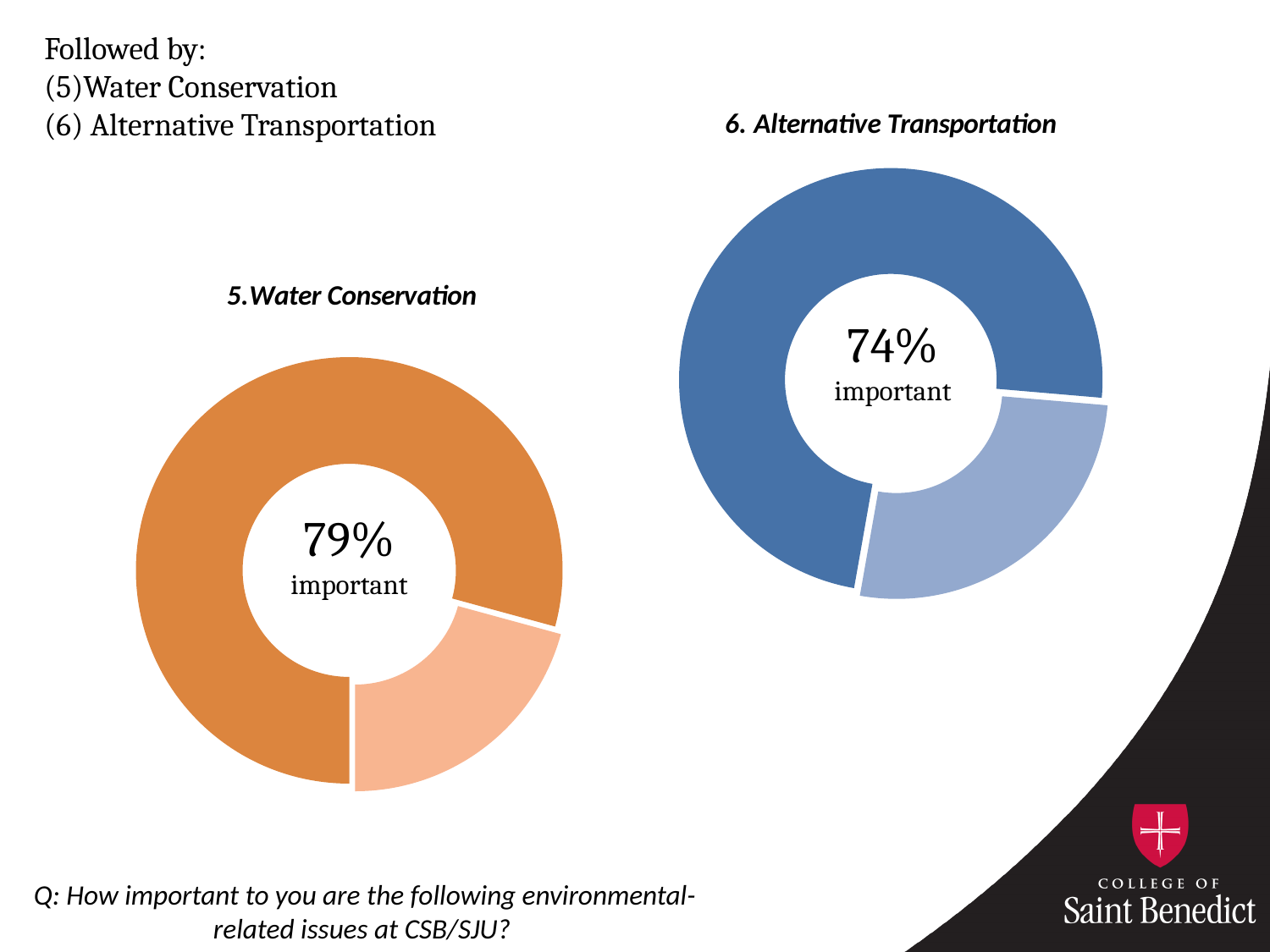
Which issue has the higher share of respondents rating it important, Water Conservation or Alternative Transportation? Water Conservation Is the 'important' share in the '5. Water Conservation' chart greater or less than 75%? greater Is the 'important' share in the '6. Alternative Transportation' chart greater or less than 50%? greater How many slices does the '6. Alternative Transportation' chart have? 2 What is the title of the chart on the right side of the slide? 6. Alternative Transportation In the '5. Water Conservation' chart, what percentage of respondents rated the issue as important? 79% What is the difference in percentage points between the 'important' share for Water Conservation and for Alternative Transportation? 5 percentage points In the '6. Alternative Transportation' chart, what percentage of respondents rated the issue as important? 74% What type of chart is used for '5. Water Conservation'? Doughnut (pie) chart How many slices does the '5. Water Conservation' chart have? 2 What colour is the larger slice in the '5. Water Conservation' chart? Orange How many charts are shown on the slide? 2